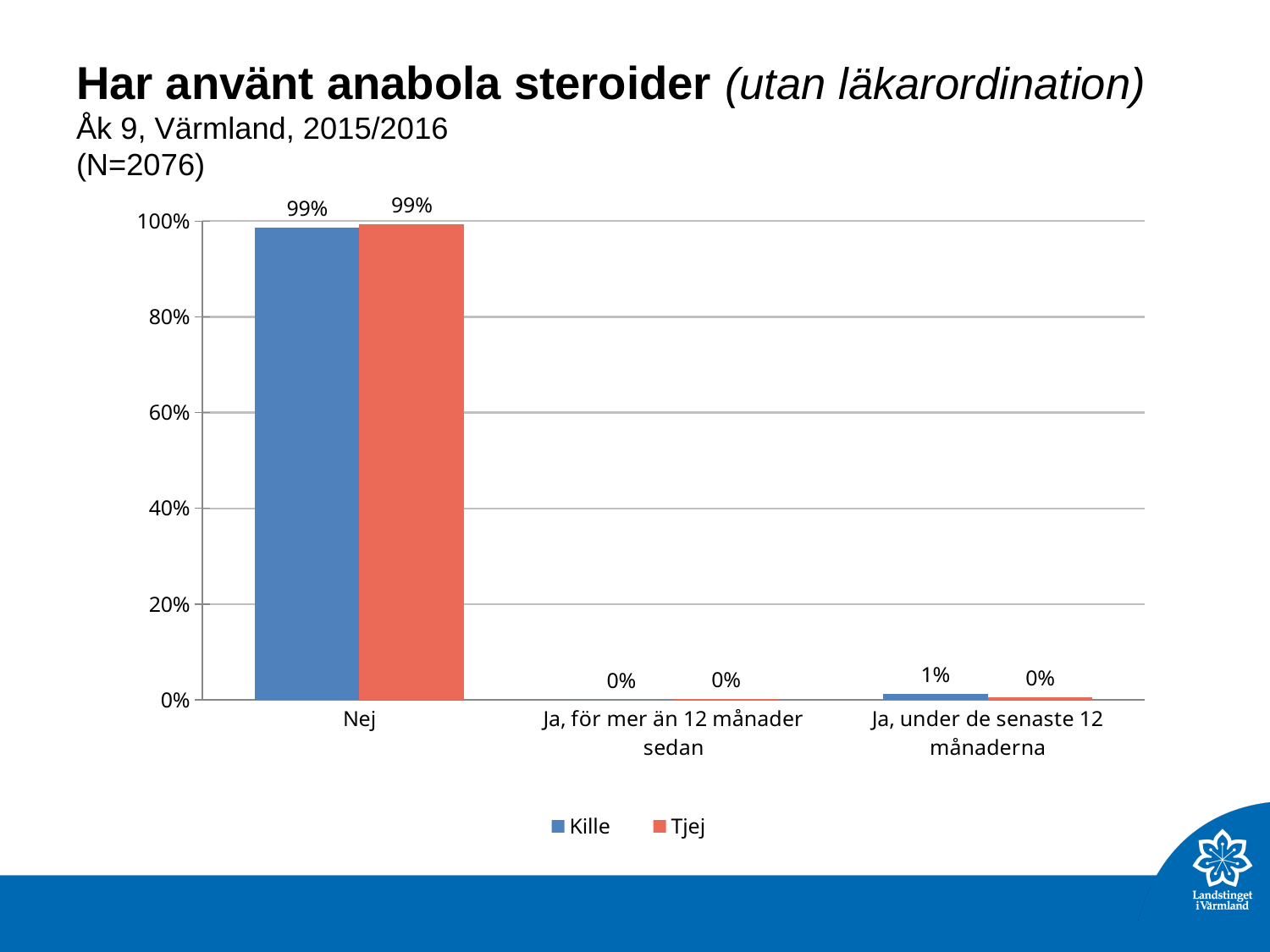
What is the value for Tjej in the category 'Ja, under de senaste 12 månaderna'? 0% Which category has the highest value for Kille? Nej What is the difference between the Kille and Tjej values in the category 'Ja, under de senaste 12 månaderna'? 1% What is the value for Kille in the Nej category? 99% What is the value for Kille in the category 'Ja, under de senaste 12 månaderna'? 1% What kind of chart is shown on the slide? bar chart How many series does the legend list? 2 Which series is shown in red/orange according to the legend? Tjej What is the value for Tjej in the category 'Ja, för mer än 12 månader sedan'? 0% Is the value for Kille in the Nej category greater or less than 80%? greater What is the value for Tjej in the Nej category? 99% How many categories are shown on the x axis? 3